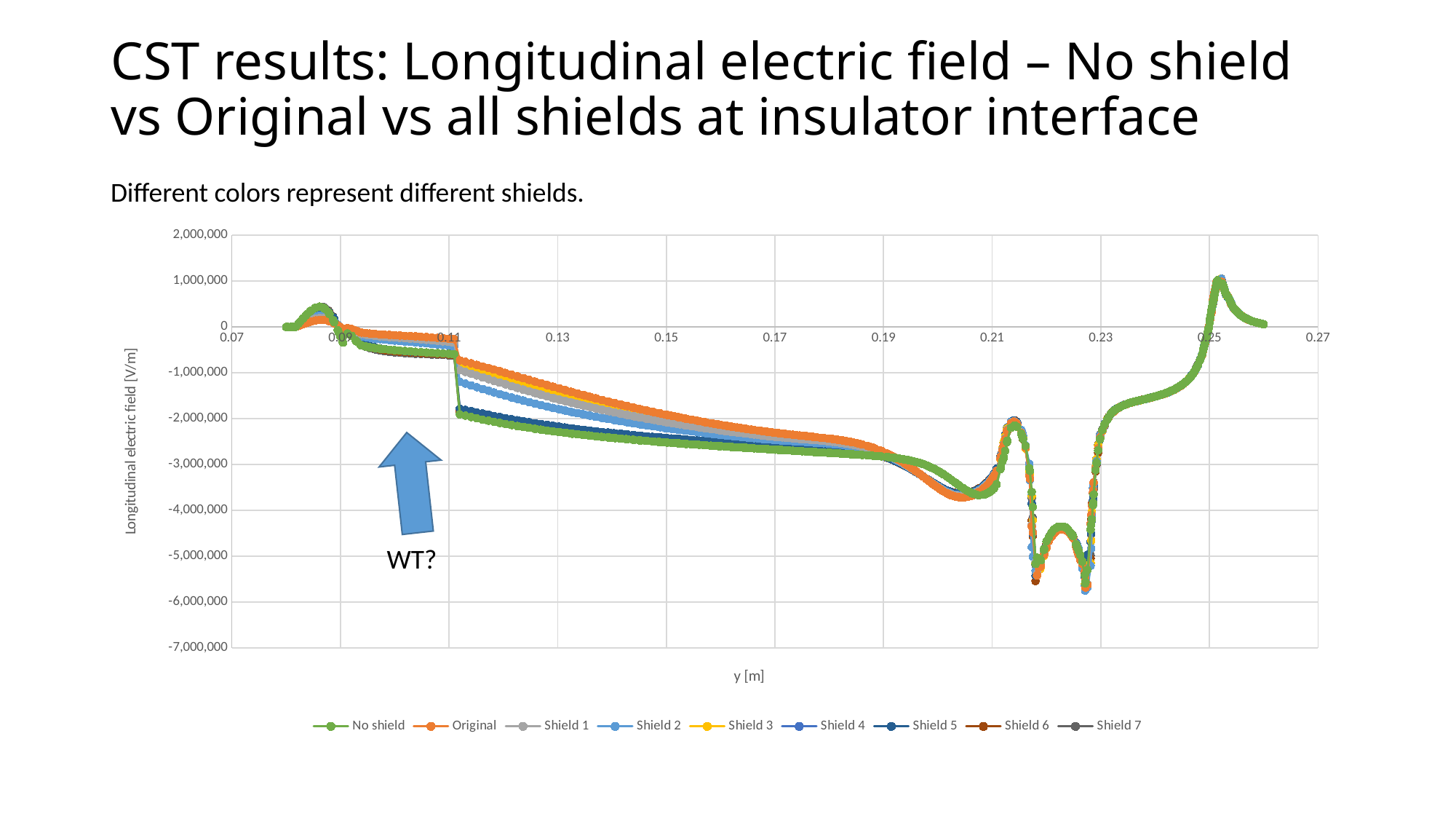
What kind of chart is shown on the slide? line chart What is the label of the y axis? Longitudinal electric field [V/m] How many series does the chart legend list? 9 Is the value of the No shield series at y = 0.17 m greater or less than -2,000,000? less Is the peak value of the curves near y = 0.25 m greater or less than 0? greater What is the label of the x axis? y [m] Between y = 0.11 m and y = 0.19 m, do the curves generally rise or fall? fall Is the lowest value of the curves near y = 0.23 m greater or less than -5,000,000? less At y = 0.13 m, which series has the larger value, Shield 5 or Original? Original At y = 0.15 m, which series has the larger value, No shield or Original? Original Between y = 0.23 m and y = 0.25 m, do the curves generally rise or fall? rise